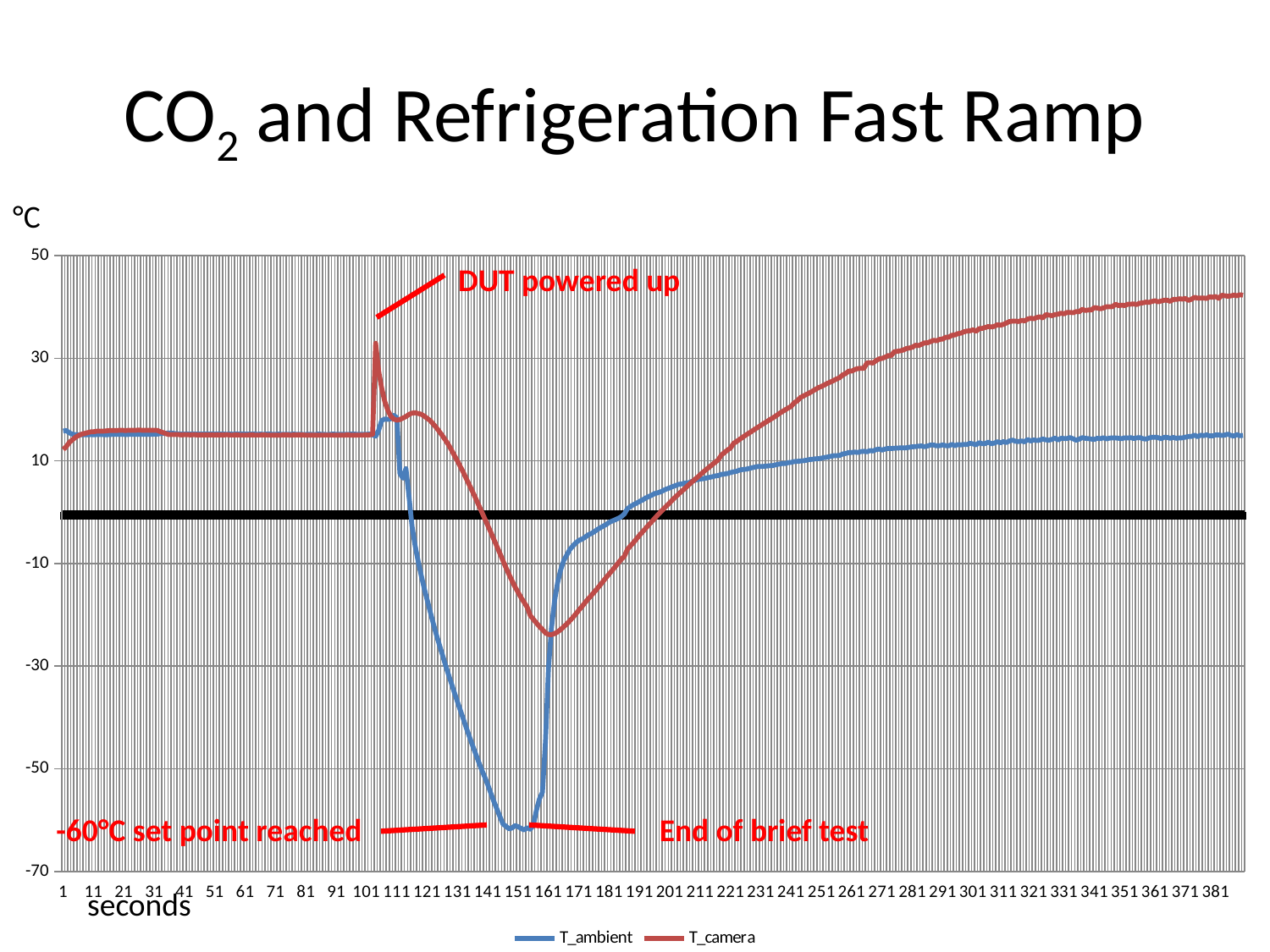
How many series does the legend list? 2 What kind of chart is shown on the slide? line chart At second 151, which series has the higher value, T_ambient or T_camera? T_camera Is the value of T_camera at second 381 greater or less than 30? greater What is the title of the chart on the slide? CO2 and Refrigeration Fast Ramp Which series reaches the lowest value on the chart? T_ambient Is the lowest value reached by T_camera greater or less than -10? less Does T_camera rise or fall between second 201 and second 381? rise Is the value of T_ambient at second 151 greater or less than -50? less At second 381, which series has the higher value, T_ambient or T_camera? T_camera What are the two series named in the legend? T_ambient and T_camera